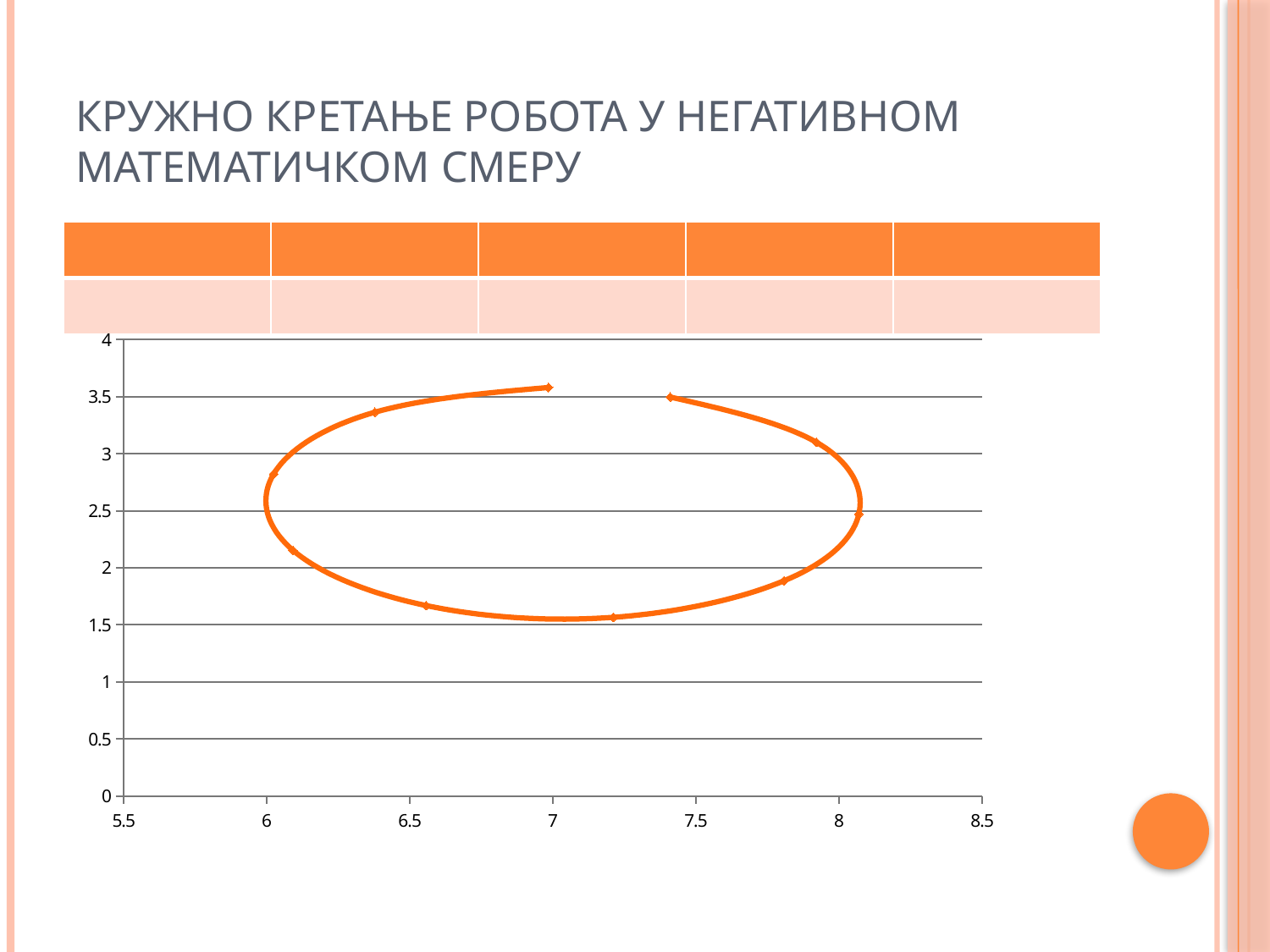
Is the smallest x value reached by the plotted curve greater or less than 6.5? less Which is larger: the y value of the topmost point of the curve or the y value of the bottommost point? The topmost point Is the y value of the point at x = 7 on the upper part of the curve greater or less than 3? greater What kind of chart is shown on the slide? Scatter chart with smoothed lines Is the y value of the lowest point of the curve greater or less than 1? greater What shape do the plotted points trace on the chart? A circle/ellipse (a loop with a small gap at the top) What is the title of the slide containing the chart? КРУЖНО КРЕТАЊЕ РОБОТА У НЕГАТИВНОМ МАТЕМАТИЧКОМ СМЕРУ